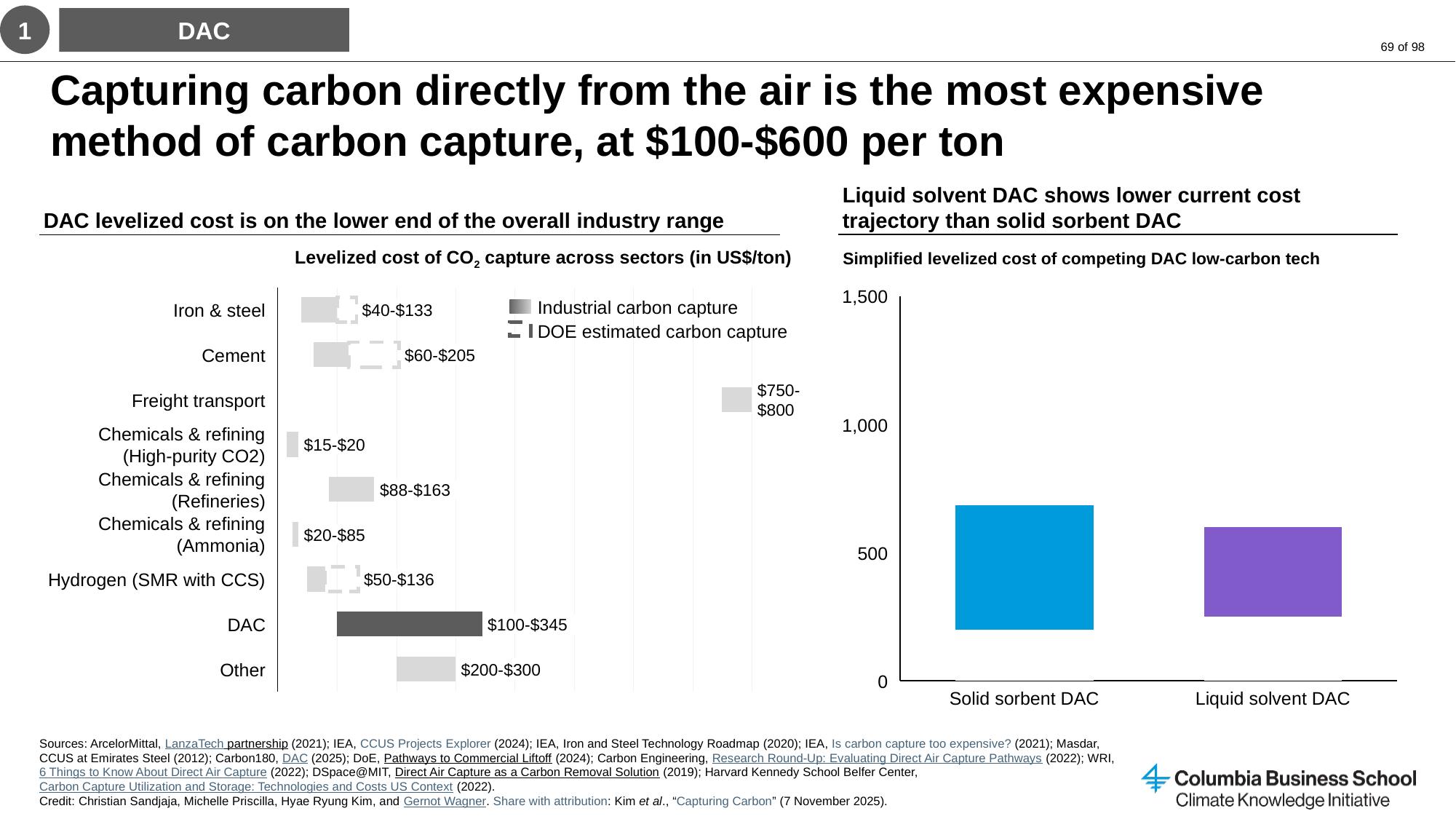
In the chart 'Levelized cost of CO2 capture across sectors', how many sectors are listed on the vertical axis? 9 In the chart 'Levelized cost of CO2 capture across sectors', how many entries does the legend list? 2 In the chart 'Simplified levelized cost of competing DAC low-carbon tech', is the lower end of the Liquid solvent DAC bar greater or less than 500? less In the chart 'Levelized cost of CO2 capture across sectors', which sector has the lowest levelized cost range? Chemicals & refining (High-purity CO2) In the chart 'Levelized cost of CO2 capture across sectors', what is the cost range shown for Cement? $60-$205 In the chart 'Levelized cost of CO2 capture across sectors', which sector has the highest levelized cost range? Freight transport In the chart 'Levelized cost of CO2 capture across sectors', what is the cost range shown for Freight transport? $750-$800 In the chart 'Simplified levelized cost of competing DAC low-carbon tech', which technology's bar reaches a higher upper cost: Solid sorbent DAC or Liquid solvent DAC? Solid sorbent DAC In the chart 'Levelized cost of CO2 capture across sectors', what is the cost range shown for DAC? $100-$345 What kind of chart is 'Levelized cost of CO2 capture across sectors'? Bar chart In the chart 'Levelized cost of CO2 capture across sectors', what is the cost range shown for Hydrogen (SMR with CCS)? $50-$136 In the chart 'Simplified levelized cost of competing DAC low-carbon tech', is the upper end of the Solid sorbent DAC bar greater or less than 1,000? less